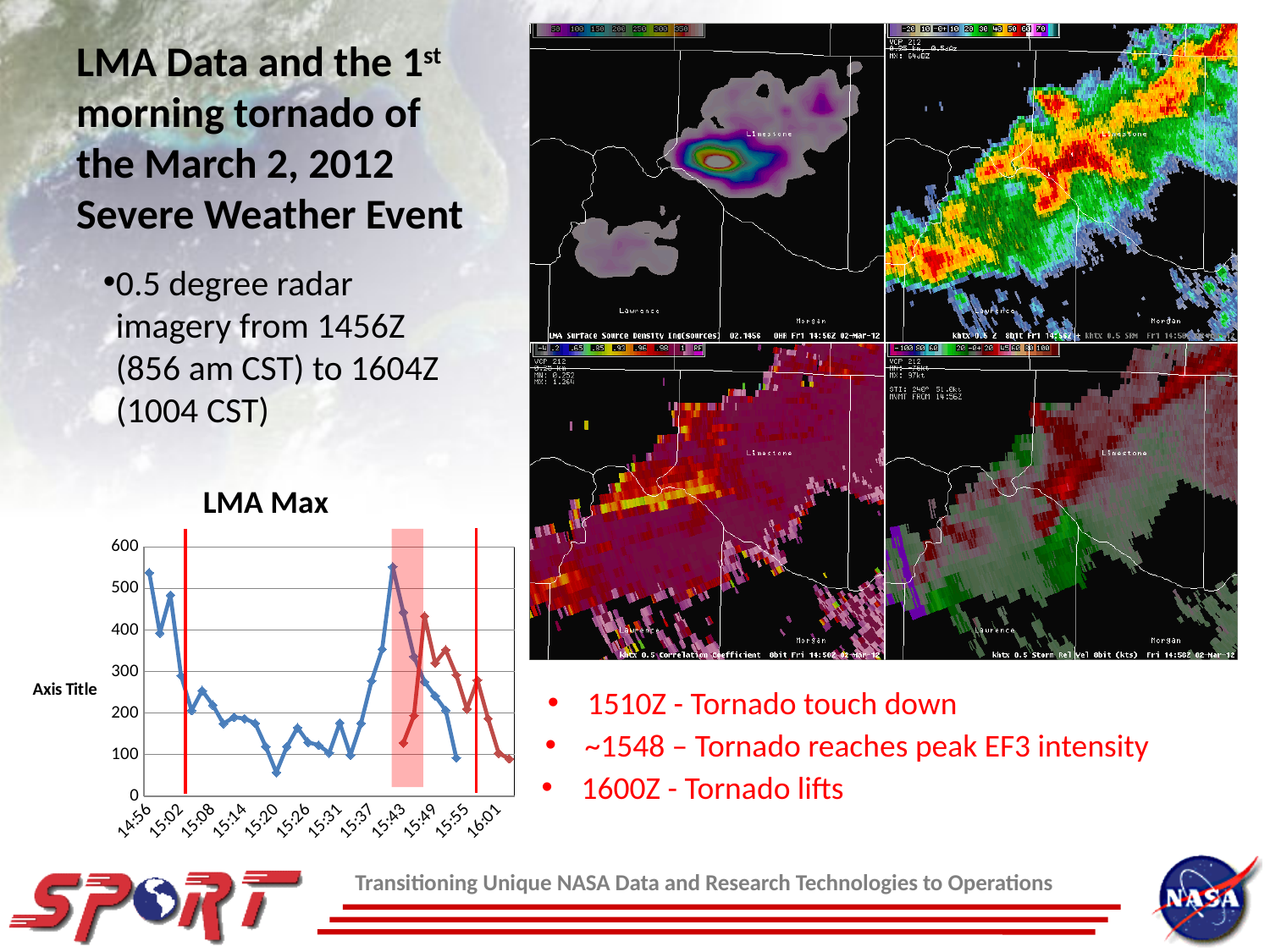
How many lines are plotted on the 'LMA Max' chart? 2 What kind of chart is the 'LMA Max' chart? line chart What is the title of the chart on the slide? LMA Max On the 'LMA Max' chart, at which time label does the blue line reach its lowest value? 15:20 How many time labels are shown along the x axis of the 'LMA Max' chart? 12 On the 'LMA Max' chart, is the blue line's value at 14:56 greater or less than 500? greater On the 'LMA Max' chart, is the blue line's value at 15:20 greater or less than 100? less What is the highest value shown on the y axis of the 'LMA Max' chart? 600 On the 'LMA Max' chart, does the blue line rise or fall between 14:56 and 15:20? fall What is the label shown on the vertical axis of the 'LMA Max' chart? Axis Title On the 'LMA Max' chart, does the blue line rise or fall between 15:20 and 15:43? rise